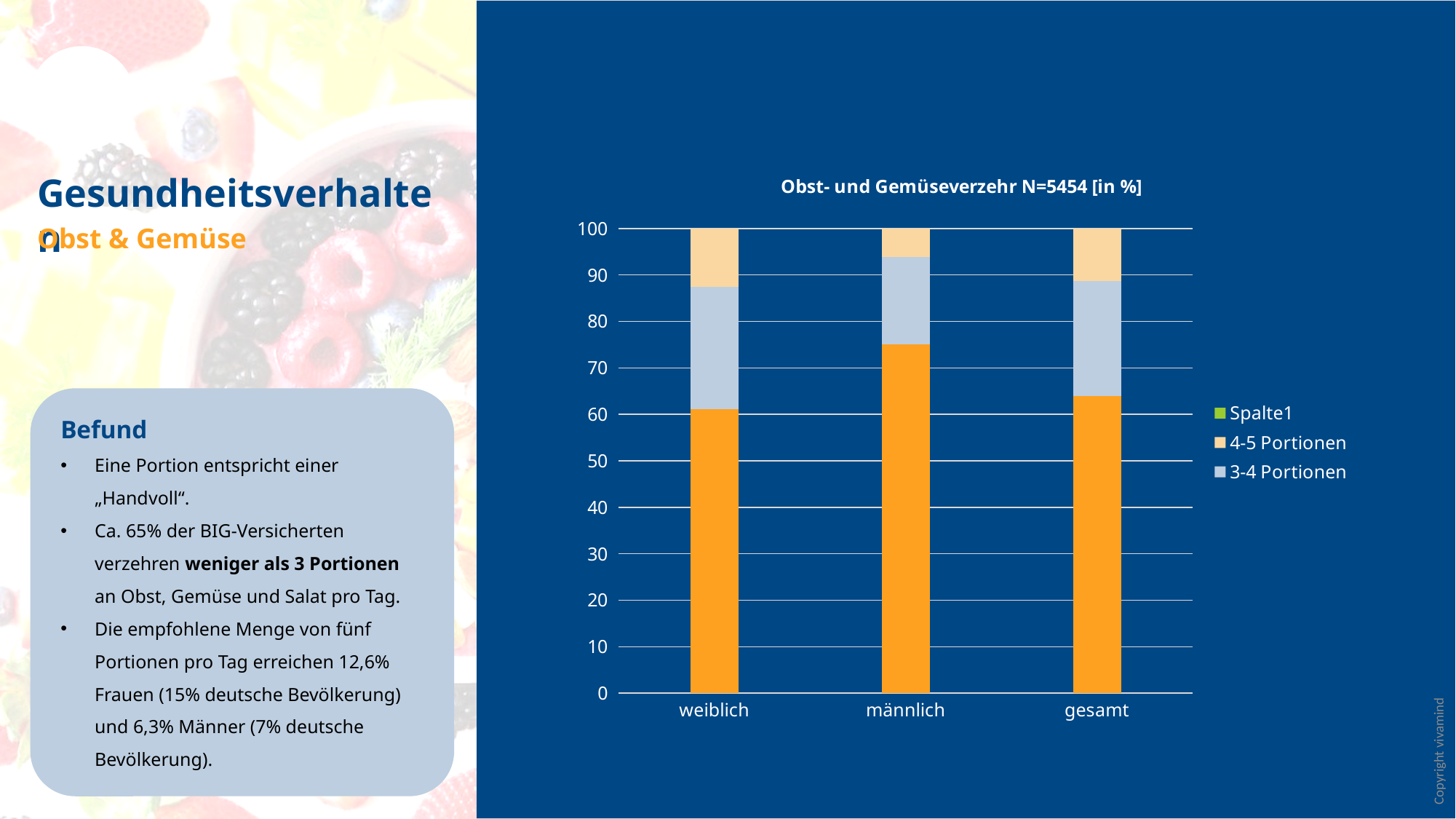
Which entries are listed in the chart legend? Spalte1, 4-5 Portionen, 3-4 Portionen Is the top of the '3-4 Portionen' segment for 'männlich' greater or less than 90? greater Is the top of the orange (bottom) segment for 'gesamt' greater or less than 60? greater Is the '4-5 Portionen' segment larger for 'weiblich' or for 'männlich'? weiblich What is the title of the chart? Obst- und Gemüseverzehr N=5454 [in %] Is the top of the orange (bottom) segment for 'männlich' greater or less than 70? greater What kind of chart is shown on the slide? Stacked bar chart How many categories are shown on the x axis of the chart? 3 How many series does the chart legend list? 3 What is the total height of the stacked bar for 'gesamt'? 100 Which category has the largest orange (bottom) segment? männlich